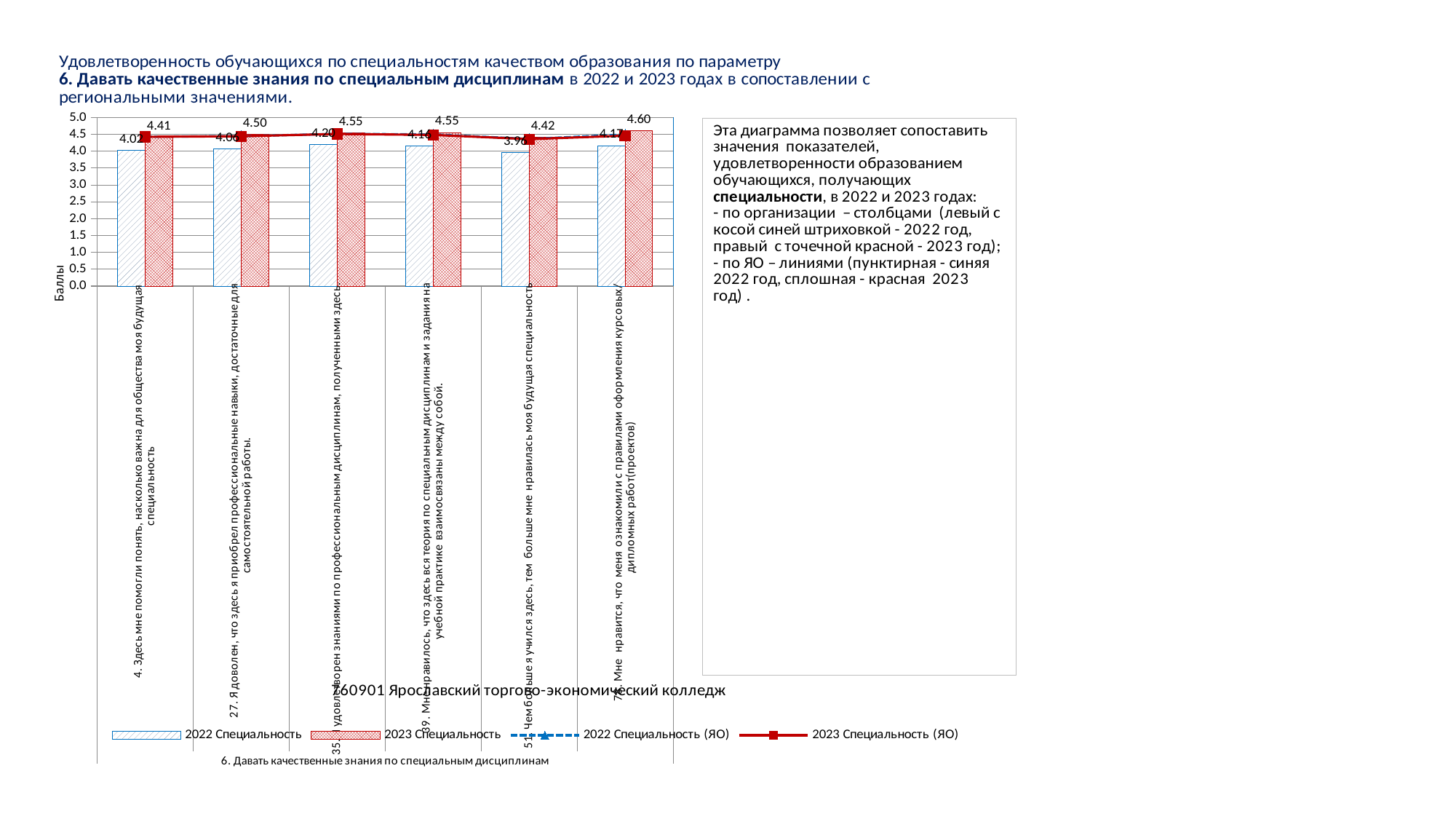
What is the difference between the highest 2023 Специальность value (4.60) and the 2023 Специальность value for the first category (4.41)? 0.19 How many series does the chart legend list? 4 What is the 2022 Специальность value for the category "4. Здесь мне помогли понять, насколько важна для общества моя будущая специальность"? 4.02 What is the 2022 Специальность value for the category "51. Чем больше я учился здесь, тем больше мне нравилась моя будущая специальность"? 3.96 How many categories are shown on the x axis of the chart? 6 What is the 2023 Специальность value for the category "4. Здесь мне помогли понять, насколько важна для общества моя будущая специальность"? 4.41 For the category "4. Здесь мне помогли понять, насколько важна для общества моя будущая специальность", how much higher is the 2023 Специальность value than the 2022 Специальность value? 0.39 Which is larger: the 2023 Специальность value for the first category ("4. Здесь мне помогли понять...") or for the last category ("Мне нравится, что меня ознакомили с правилами оформления курсовых/дипломных работ(проектов)")? The last category (4.60) Which category has the highest 2023 Специальность value? Мне нравится, что меня ознакомили с правилами оформления курсовых/дипломных работ(проектов) (4.60) Is the 2022 Специальность value for the category "51. Чем больше я учился здесь, тем больше мне нравилась моя будущая специальность" greater or less than 4.0? less Which category has the lowest 2022 Специальность value? 51. Чем больше я учился здесь, тем больше мне нравилась моя будущая специальность (3.96) What type of chart is shown on the slide? A combined bar and line chart